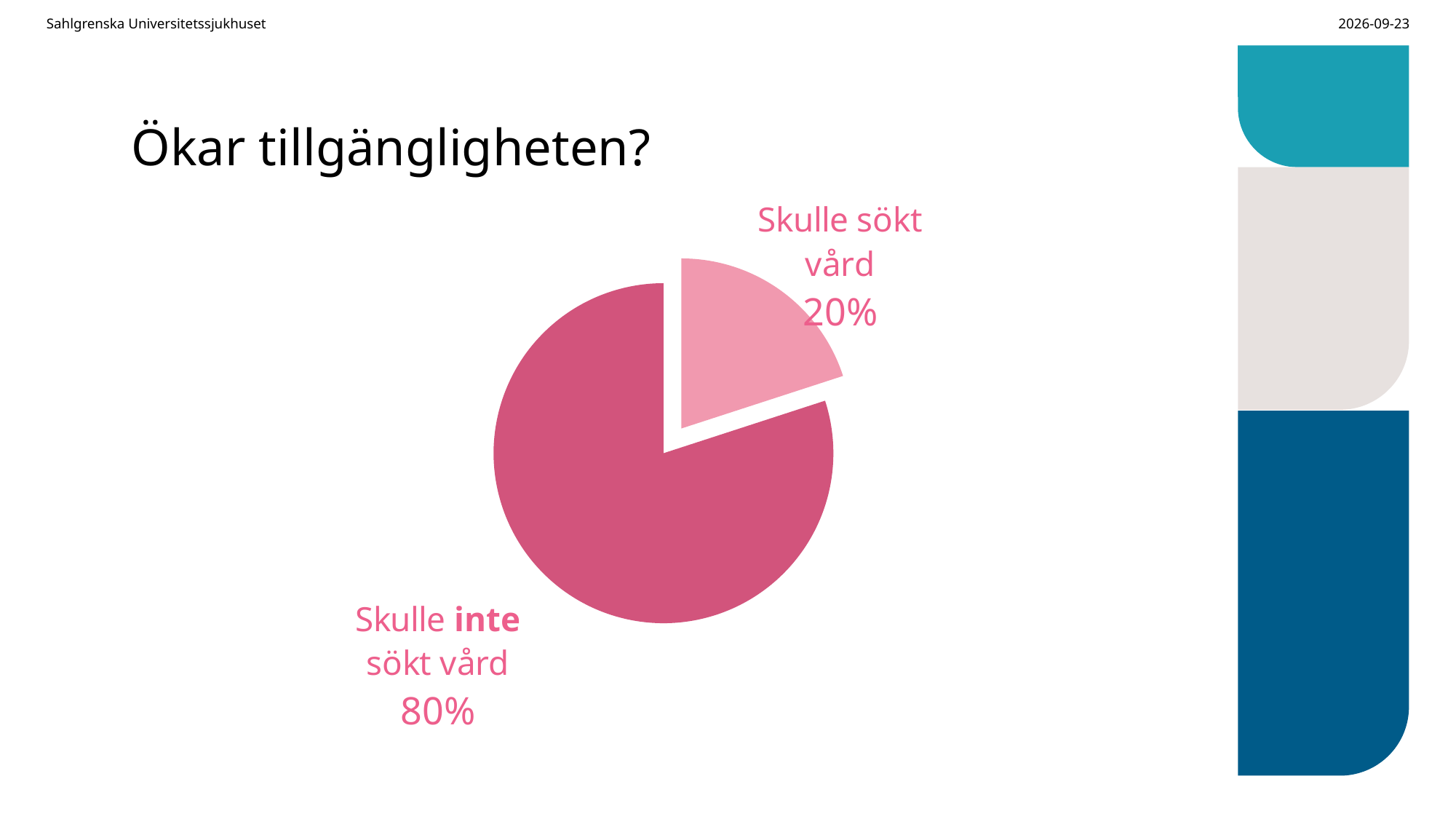
What kind of chart is shown on the slide? pie chart What is the title of the slide containing the pie chart? Ökar tillgängligheten? Which slice of the pie is the largest? Skulle inte sökt vård What is the difference in percentage points between the "Skulle inte sökt vård" slice and the "Skulle sökt vård" slice? 60 percentage points Which slice of the pie is pulled out (exploded) from the rest? Skulle sökt vård How many slices does the pie chart have? 2 Which slice of the pie is the smallest? Skulle sökt vård Which is larger: the "Skulle sökt vård" slice or the "Skulle inte sökt vård" slice? Skulle inte sökt vård What share of the pie is labelled "Skulle sökt vård"? 20% What share of the pie is labelled "Skulle inte sökt vård"? 80%